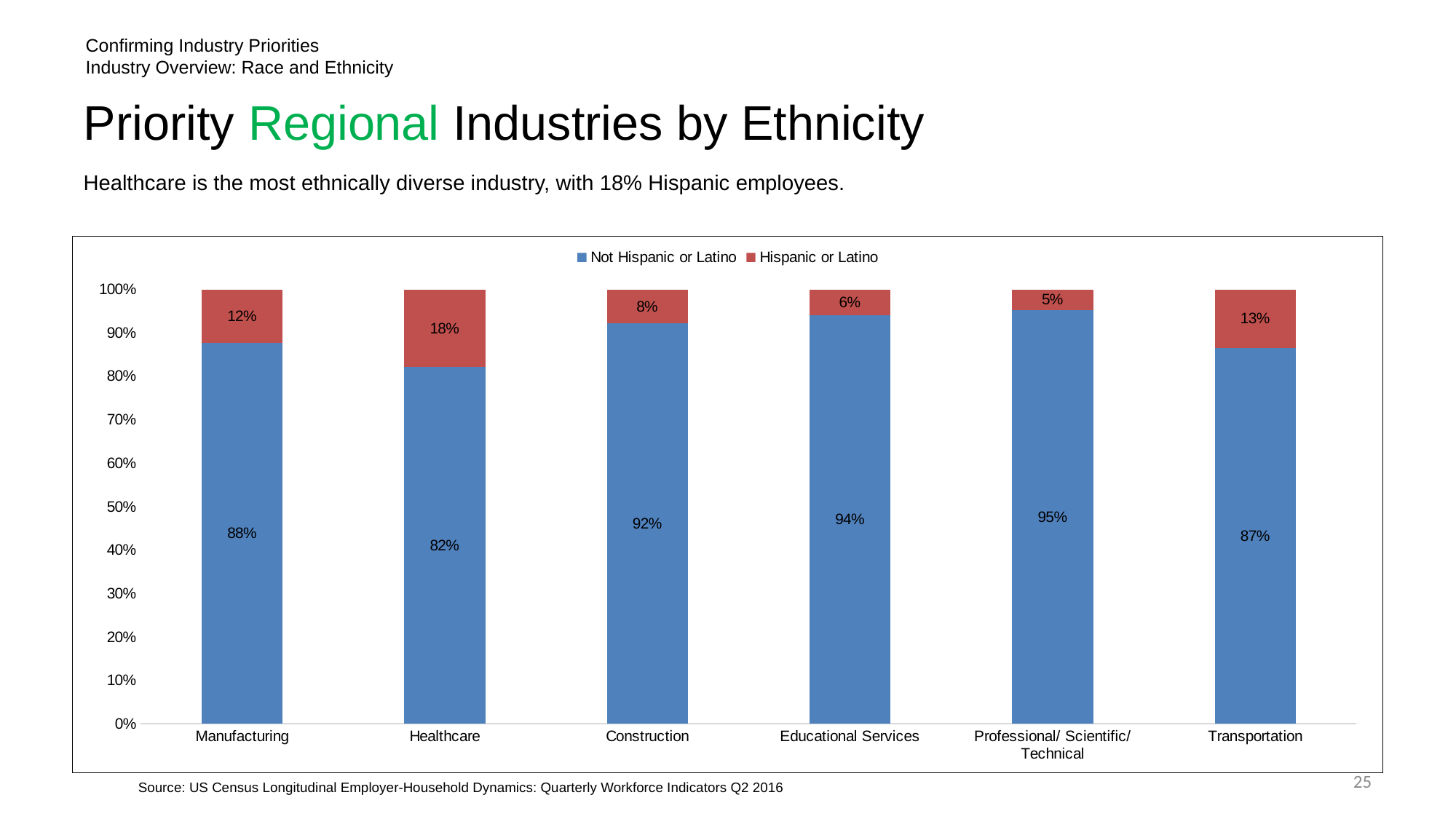
Which colour represents Hispanic or Latino in the legend? Red How many series does the legend list? 2 How many industries are shown on the x axis? 6 What is the Hispanic or Latino share for Transportation? 13% What is the difference between the Hispanic or Latino shares for Healthcare and Manufacturing? 6% Which has a larger Not Hispanic or Latino share, Educational Services or Transportation? Educational Services What is the Hispanic or Latino share for Healthcare? 18% Which industry has the highest Hispanic or Latino share? Healthcare What is the total of the stacked bar for Manufacturing? 100% What kind of chart is shown? Stacked bar chart Which industry has the lowest Hispanic or Latino share? Professional/ Scientific/ Technical What is the Not Hispanic or Latino share for Construction? 92%